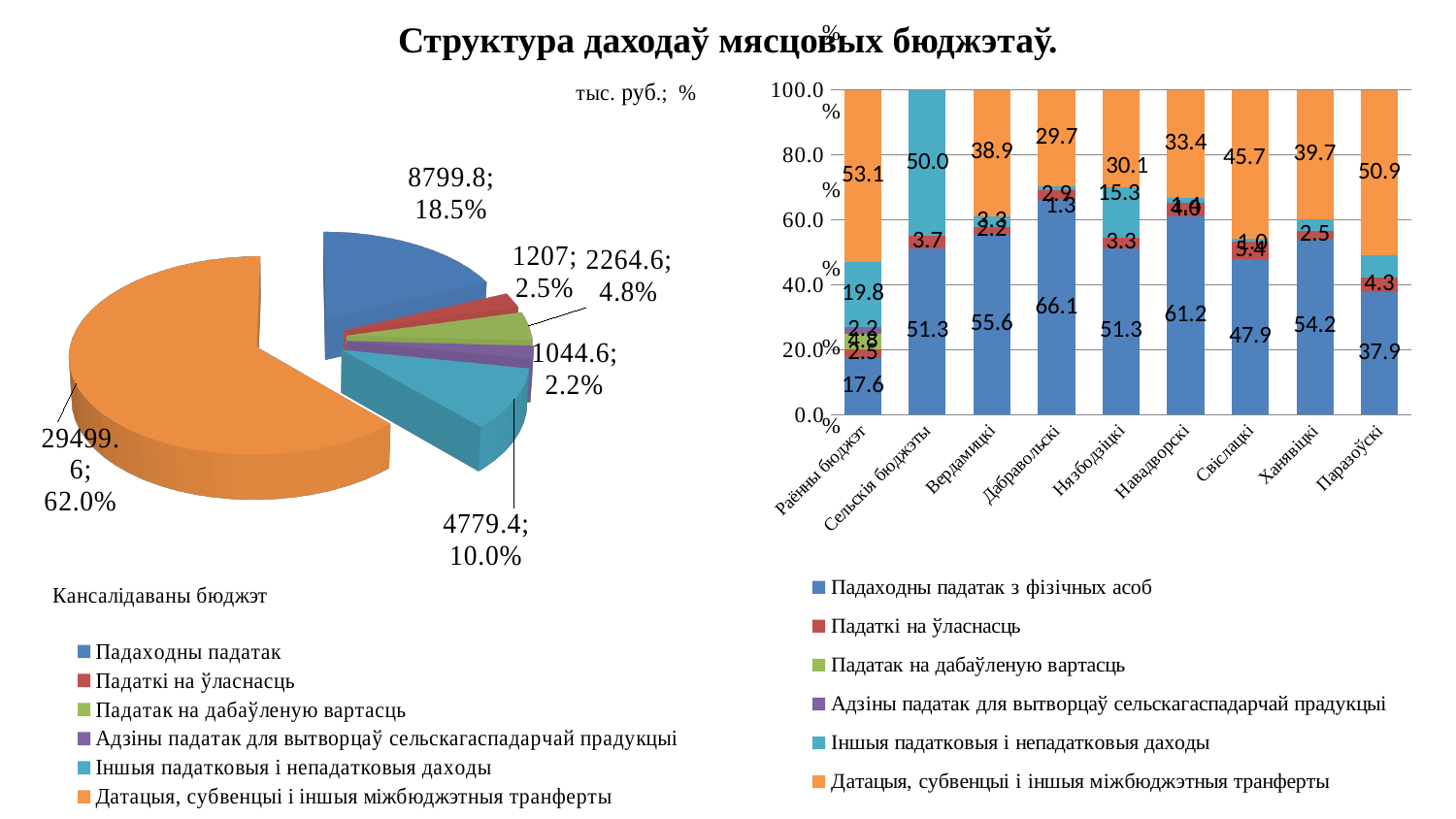
In the bar chart on the right, how many categories are shown on the x axis? 9 In the pie chart on the left, what share does the 'Датацыя, субвенцыі і іншыя міжбюджэтныя трансферты' slice have? 62.0% What kind of chart is on the right side of the slide? Stacked bar chart In the bar chart on the right, how many series does the legend list? 6 In the bar chart on the right, which category has the lowest value for 'Падаходны падатак з фізічных асоб'? Раённы бюджэт In the bar chart on the right, what is the difference between the 'Падаходны падатак з фізічных асоб' values for Дабравольскі and Паразоўскі? 28.2 In the pie chart on the left, what value is shown for 'Падаходны падатак'? 8799.8; 18.5% In the bar chart on the right, what is the value of 'Падаходны падатак з фізічных асоб' for Дабравольскі? 66.1 In the pie chart on the left, which category has the smallest slice? Адзіны падатак для вытворцаў сельскагаспадарчай прадукцыі In the pie chart on the left, how many slices are there? 6 In the pie chart on the left, what is the percentage shown for 'Іншыя падатковыя і непадатковыя даходы'? 10.0% In the bar chart on the right, what is the value of 'Датацыя, субвенцыі і іншыя міжбюджэтныя трансферты' for Раённы бюджэт? 53.1